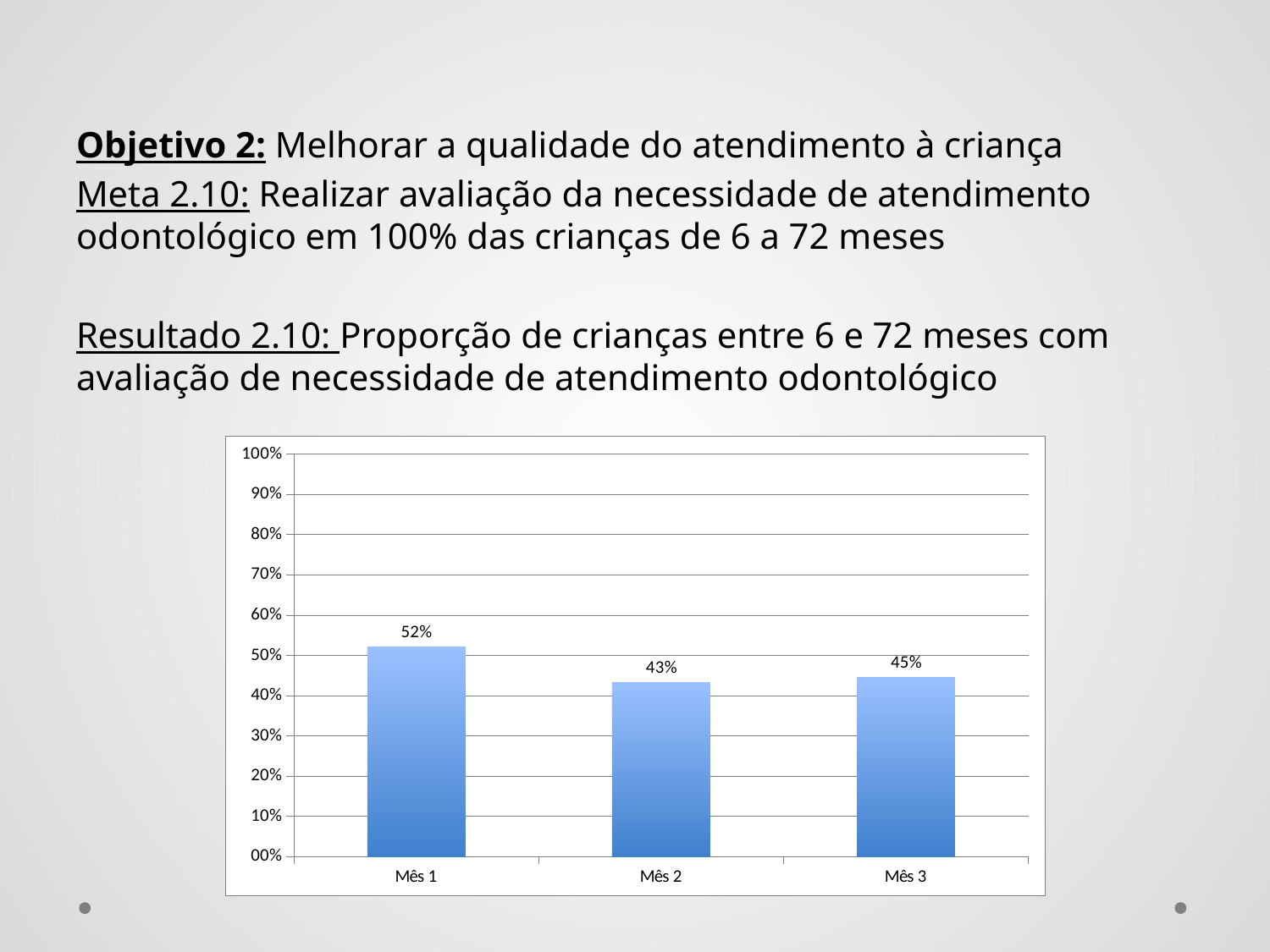
What is the value for Mês 1? 52% Which month has the lowest value? Mês 2 Is the value for Mês 2 greater or less than 50%? less What is the highest value shown on the y axis? 100% What is the difference between the values for Mês 3 and Mês 2? 2% What is the value for Mês 2? 43% How many months are shown on the x axis? 3 What is the difference between the values for Mês 1 and Mês 2? 9% Which is larger, the value for Mês 1 or the value for Mês 3? Mês 1 Which month has the highest value? Mês 1 What kind of chart is shown on the slide? bar chart What is the value for Mês 3? 45%